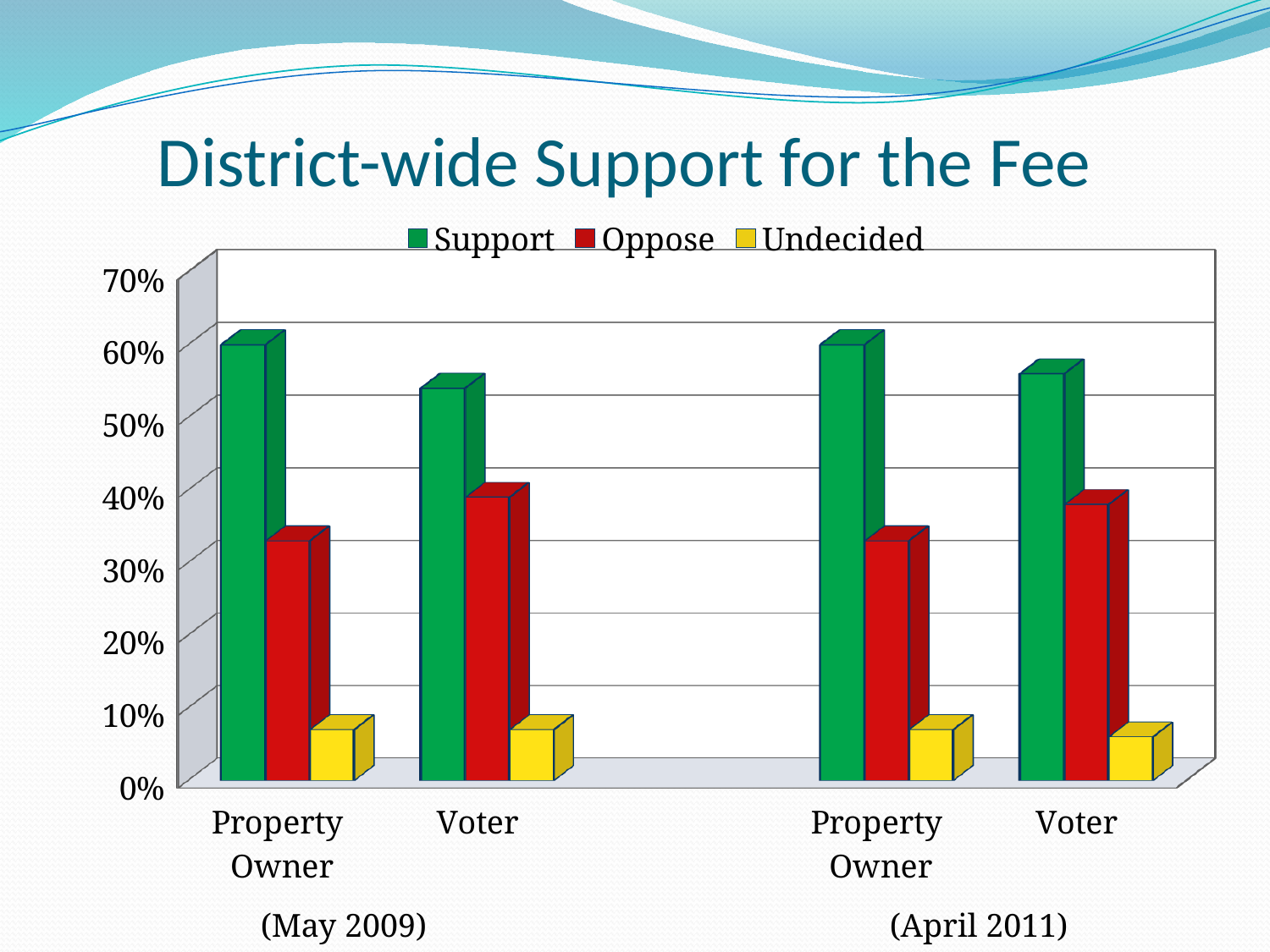
Which series has the lowest value for Voter (May 2009)? Undecided Which is larger: the Oppose value for Voter (May 2009) or the Oppose value for Property Owner (May 2009)? Voter (May 2009) How many category groups are plotted along the x axis? 4 Which series has the highest value for Property Owner (April 2011)? Support Is the Oppose value for Voter (May 2009) greater or less than 30%? greater Is the Undecided value for Voter (April 2011) greater or less than 10%? less What kind of chart is shown on the slide? bar chart Is the Support value for Property Owner (May 2009) greater or less than 50%? greater For Voter (April 2011), which is larger: Support or Oppose? Support What is the title of the chart? District-wide Support for the Fee How many series does the legend list? 3